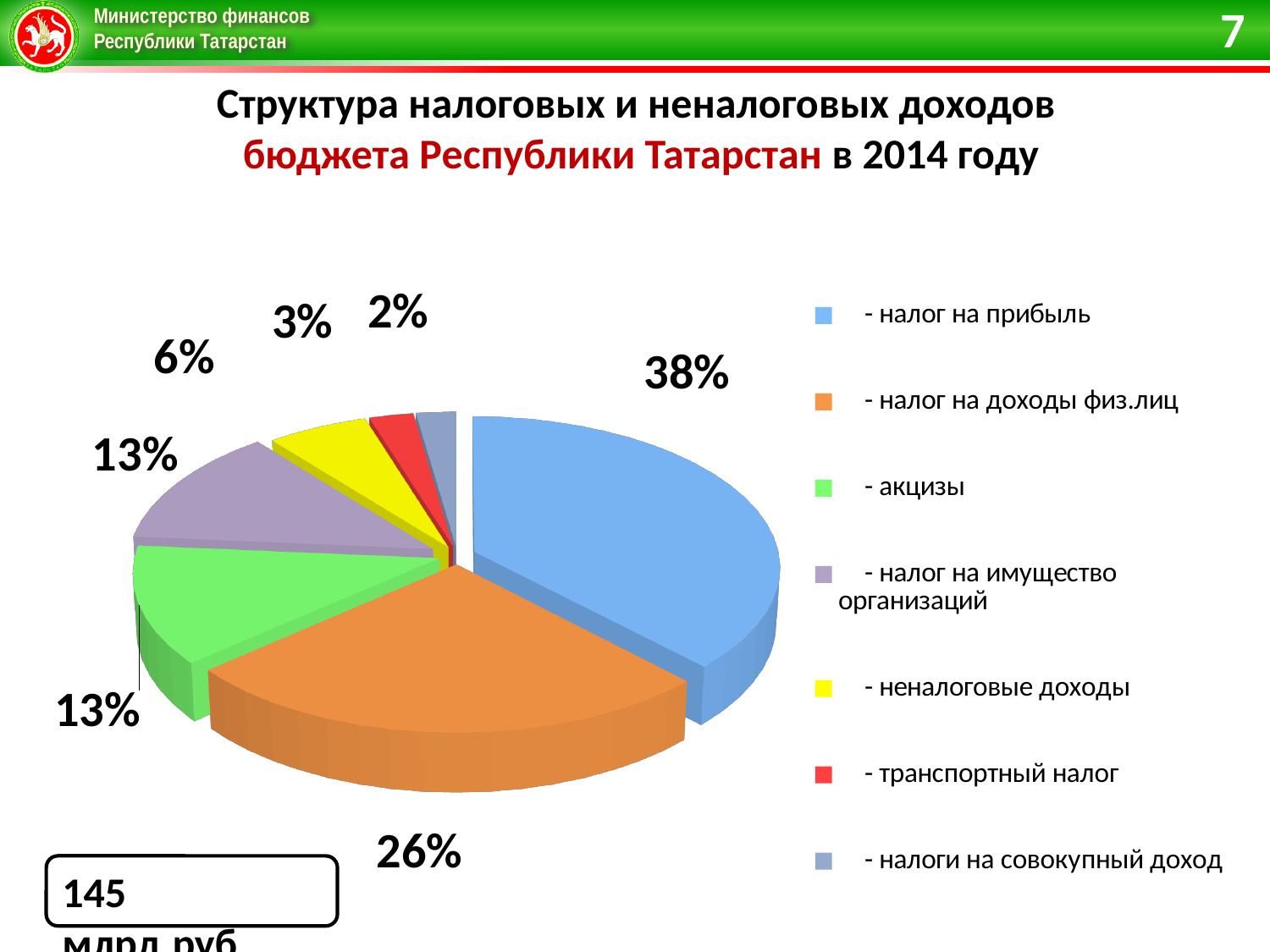
Which colour represents налог на имущество организаций in the legend? purple Which is larger, the share of неналоговые доходы or the share of транспортный налог? неналоговые доходы How many slices does the pie chart have? 7 What share of the pie does налог на прибыль account for? 38% What kind of chart is shown on the slide? pie chart Which category has the largest slice of the pie? налог на прибыль What is the difference between the shares of налог на прибыль and налог на доходы физ.лиц? 12% What is the value shown for налог на доходы физ.лиц? 26% What is the value shown for акцизы? 13% What is the value shown for транспортный налог? 3% What is the value shown for неналоговые доходы? 6% Which category has the smallest slice of the pie? налоги на совокупный доход